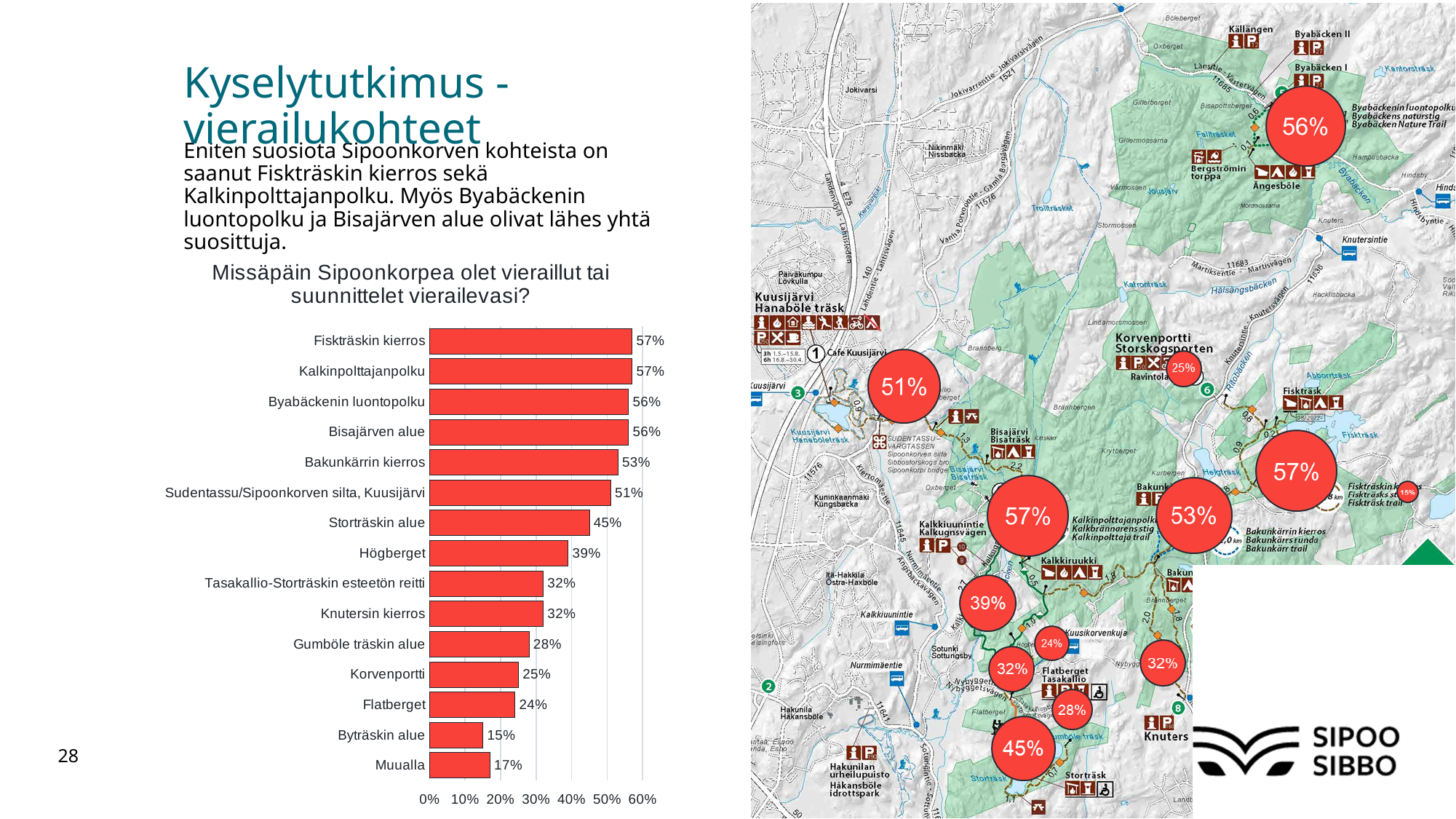
What is the difference between the values for Bakunkärrin kierros and Gumböle träskin alue? 25% How many categories are shown in the bar chart? 15 What is the value for Korvenportti? 25% What is the value for Högberget? 39% Which is larger, the value for Bisajärven alue or the value for Knutersin kierros? Bisajärven alue What is the difference between the values for Storträskin alue and Flatberget? 21% Is the value for Sudentassu/Sipoonkorven silta, Kuusijärvi greater or less than 40%? greater What kind of chart is shown on the slide? bar chart Which category has the lowest value? Byträskin alue What is the value for Muualla? 17% What is the value for Fiskträskin kierros? 57% What is the title of the bar chart? Missäpäin Sipoonkorpea olet vieraillut tai suunnittelet vierailevasi?